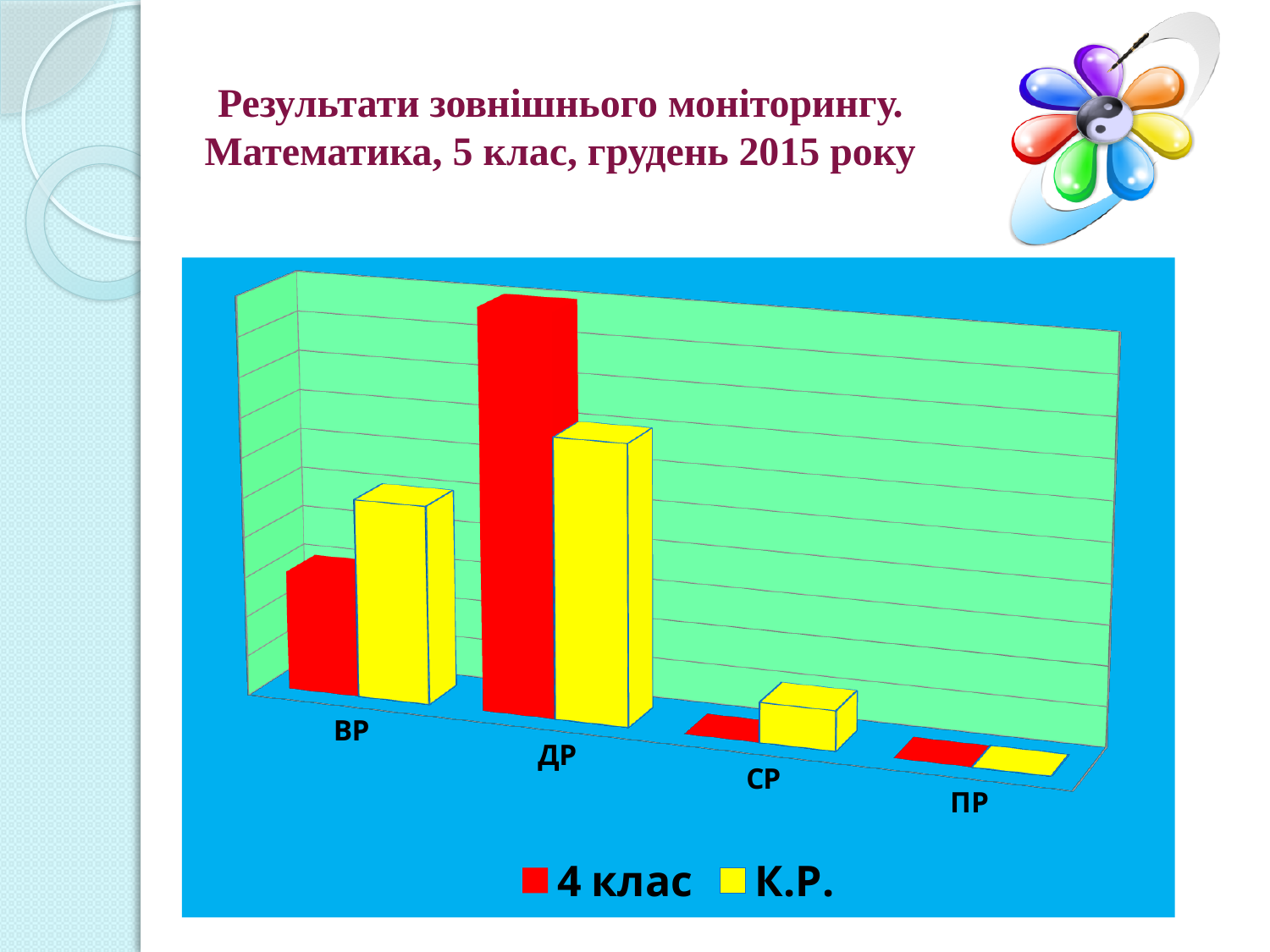
For the category СР, which series has the larger value, 4 клас or К.Р.? К.Р. For the category ДР, which series has the larger value, 4 клас or К.Р.? 4 клас Which category has the highest value for the 4 клас series? ДР How many series does the chart's legend list? 2 Which series is shown in yellow in the chart? К.Р. Which category has the highest value for the К.Р. series? ДР Which series is shown in red in the chart? 4 клас Which category has the lowest value for the К.Р. series? ПР How many categories are shown on the x axis of the chart? 4 What kind of chart is shown on the slide? bar chart For the category ВР, which series has the larger value, 4 клас or К.Р.? К.Р.